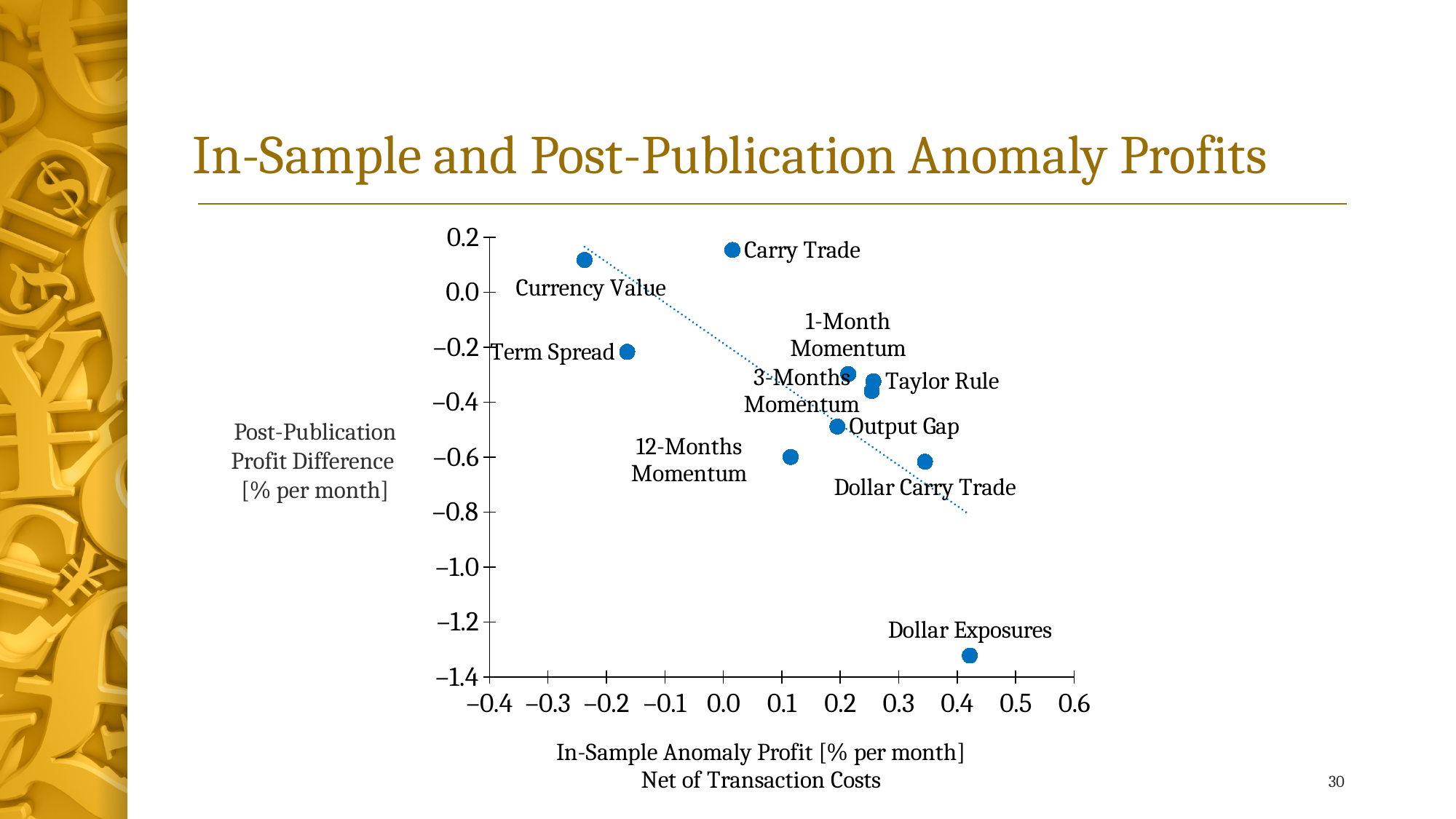
Which anomaly has the lowest Post-Publication Profit Difference? Dollar Exposures What is the label of the x axis? In-Sample Anomaly Profit [% per month] Net of Transaction Costs Is the Post-Publication Profit Difference for Dollar Exposures greater or less than -1.2? less How many labeled data points are plotted on the chart? 10 Is the In-Sample Anomaly Profit for Term Spread greater or less than 0.0? less Which has a larger In-Sample Anomaly Profit, Dollar Carry Trade or 12-Months Momentum? Dollar Carry Trade Is the Post-Publication Profit Difference for Carry Trade greater or less than 0.0? greater Which has a higher Post-Publication Profit Difference, Term Spread or Output Gap? Term Spread What kind of chart is shown on the slide? Scatter plot Which anomaly has the highest In-Sample Anomaly Profit? Dollar Exposures Which anomaly has the lowest In-Sample Anomaly Profit? Currency Value As In-Sample Anomaly Profit increases along the x axis, does the Post-Publication Profit Difference generally rise or fall? fall